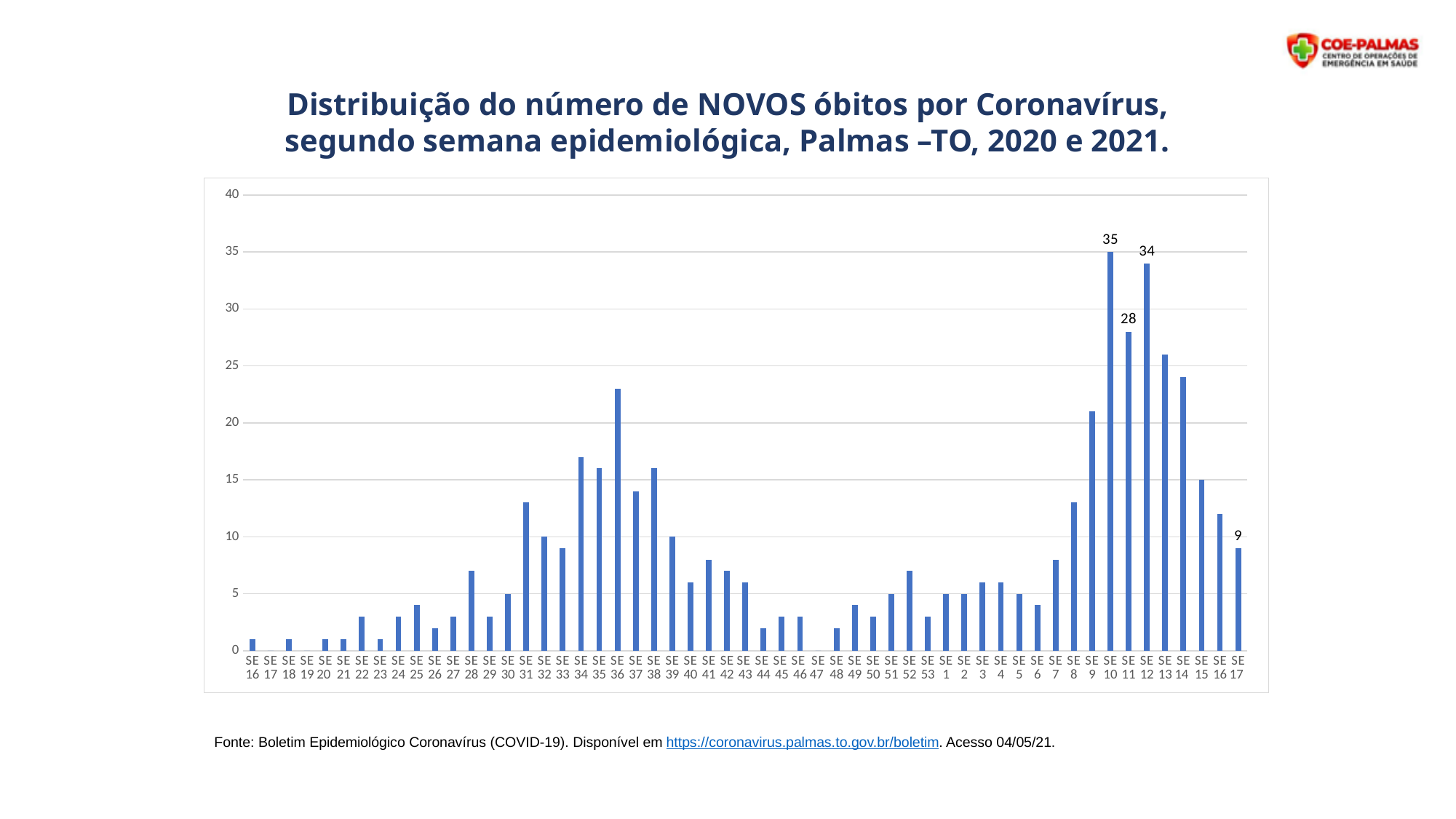
Which is larger, the value for SE 11 or the value for SE 12? SE 12 What is the value for the last bar, SE 17 of 2021? 9 What is the difference between the values for SE 10 and SE 11? 7 Which epidemiological week has the highest number of new deaths? SE 10 What is the value for SE 12 (2021)? 34 Is the value for SE 36 greater or less than 20? greater What kind of chart is shown on the slide? bar chart What is the value for SE 10 (2021)? 35 What is the value for SE 11 (2021)? 28 What is the title of the chart? Distribuição do número de NOVOS óbitos por Coronavírus, segundo semana epidemiológica, Palmas –TO, 2020 e 2021. What is the difference between the values for SE 10 and SE 12? 1 Is the value for SE 8 (2021) greater or less than 10? greater